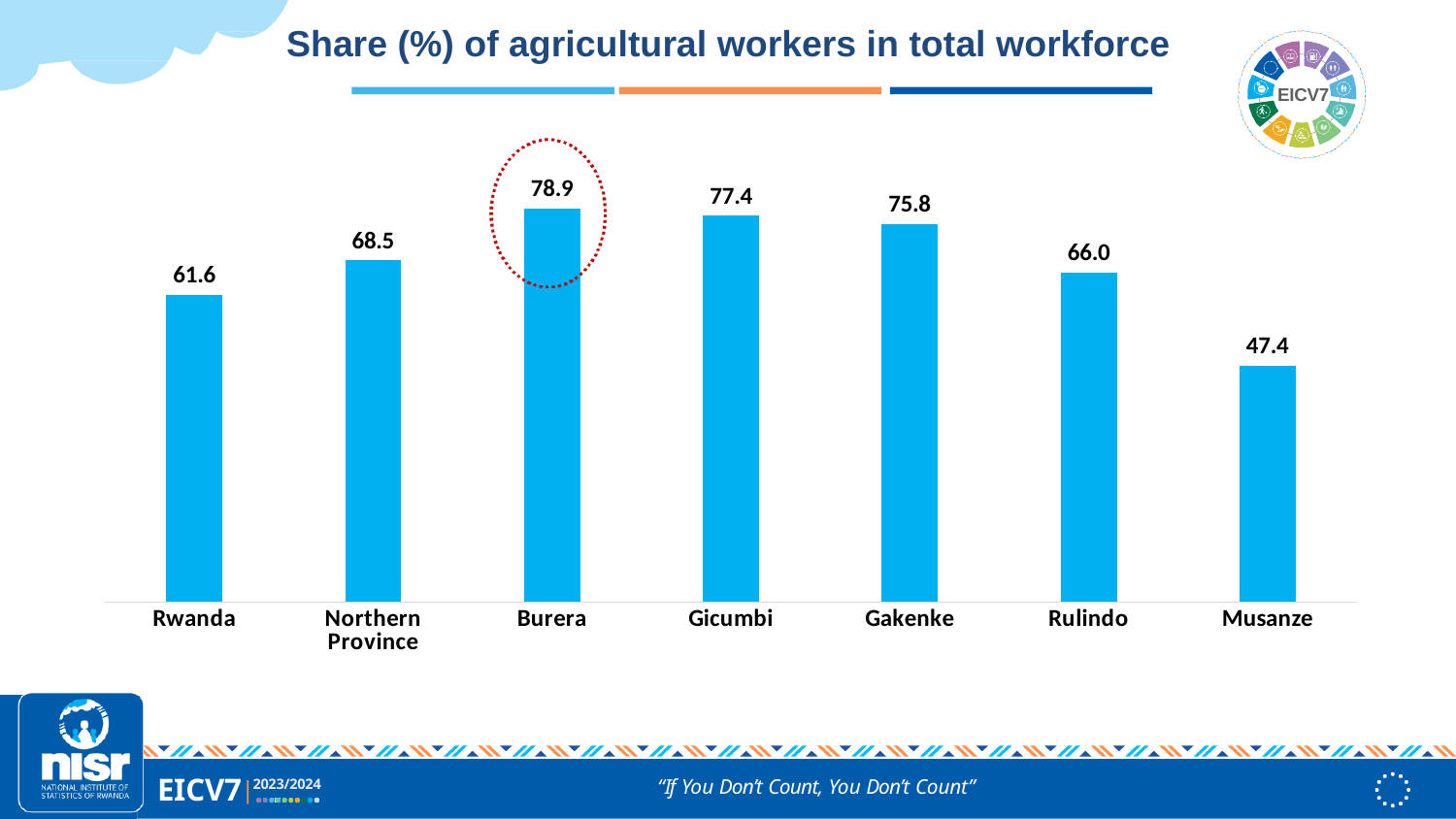
Which category has the highest share of agricultural workers? Burera What is the value shown for Rwanda? 61.6 What is the share of agricultural workers in the total workforce for Burera? 78.9 What kind of chart is shown on the slide? Bar chart Which bar is highlighted with a dotted red circle? Burera How many categories are shown on the x axis? 7 Which category has the lowest share of agricultural workers? Musanze What is the difference between the values for Northern Province and Rwanda? 6.9 What is the value shown for Musanze? 47.4 What is the difference between the values for Burera and Musanze? 31.5 Which is larger, the value for Gicumbi or the value for Rulindo? Gicumbi What is the title of the chart? Share (%) of agricultural workers in total workforce